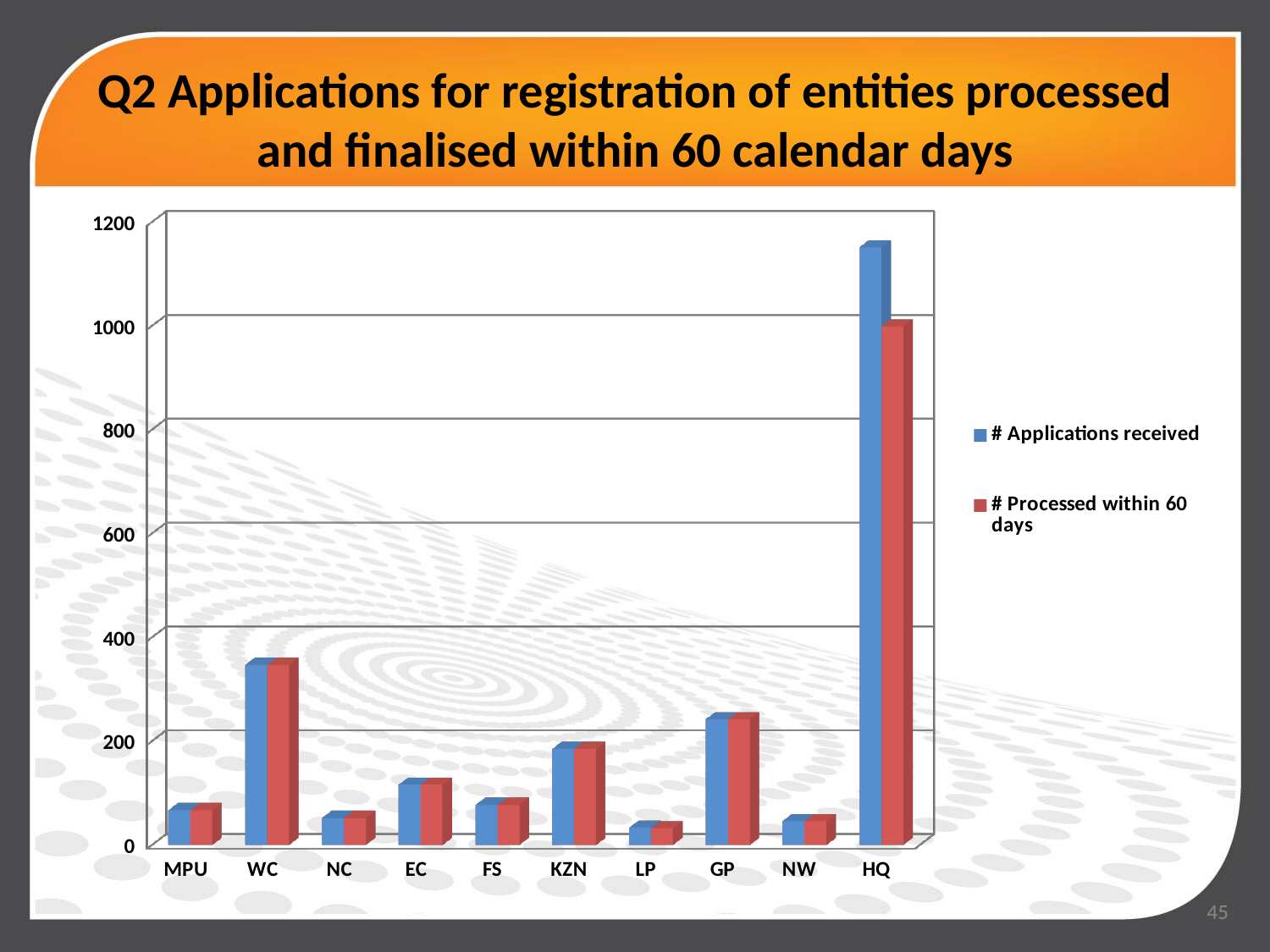
Which has the larger value for # Applications received, WC or GP? WC Is the value of # Applications received for WC greater or less than 400? less Which category has the highest value for # Processed within 60 days? HQ What colour are the bars for # Applications received? blue Is the value of # Applications received for GP greater or less than 200? greater Which category has the highest value for # Applications received? HQ How many series does the legend list? 2 Which has the larger value for # Applications received, KZN or EC? KZN How many categories are shown on the x axis of the chart? 10 What kind of chart is shown on the slide? bar chart Is the value of # Applications received for HQ greater or less than 1000? greater